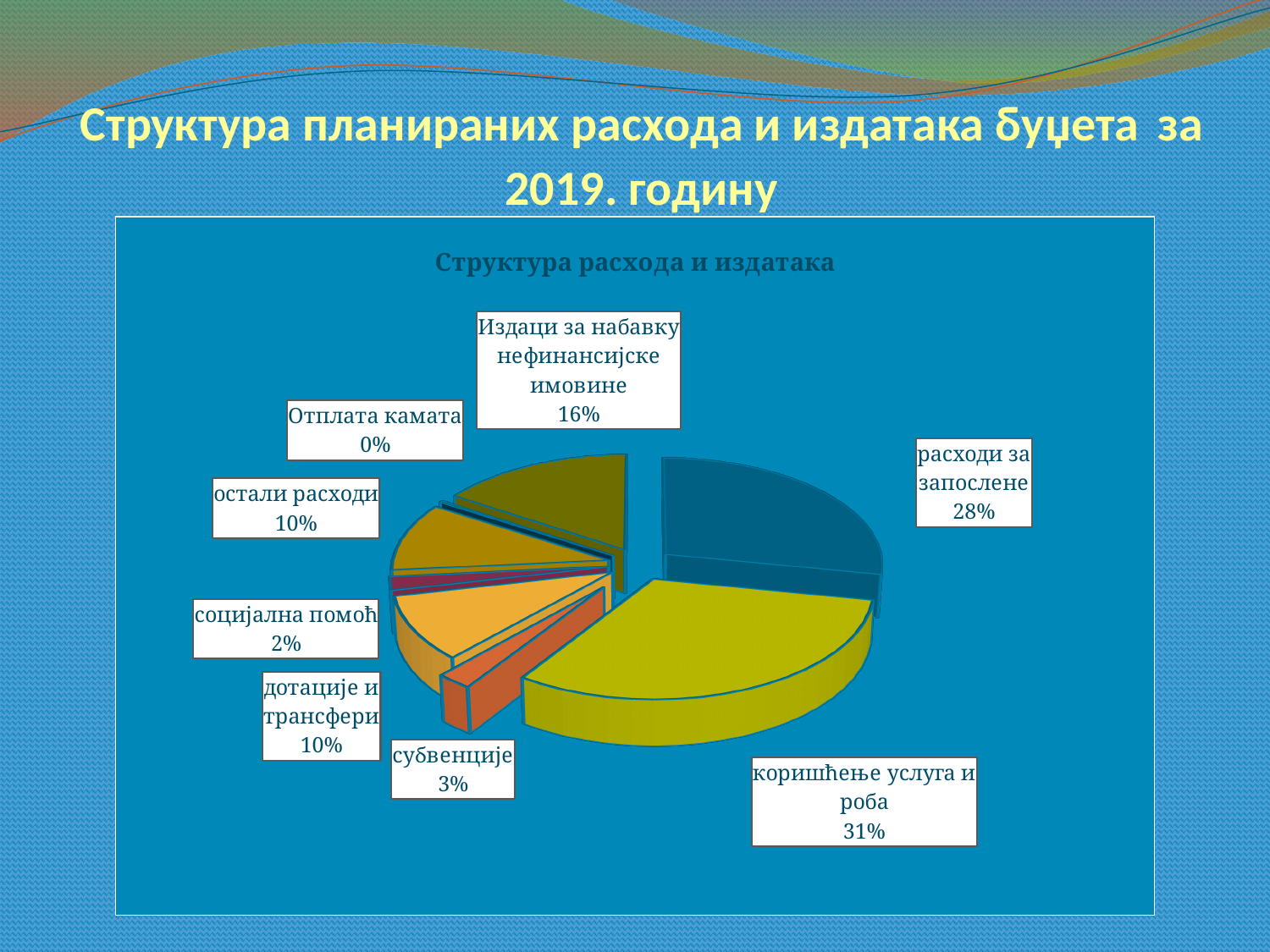
What is the difference in percentage points between коришћење услуга и роба and расходи за запослене? 3 What share of the pie is labelled for расходи за запослене? 28% Which category has the largest share of the pie? коришћење услуга и роба What is the title of the chart? Структура расхода и издатака How many categories (slices) are labelled on the pie chart? 8 What percentage is shown for социјална помоћ? 2% What percentage is shown for Издаци за набавку нефинансијске имовине? 16% What share of the pie is labelled for коришћење услуга и роба? 31% What percentage is shown for субвенције? 3% What kind of chart is shown on the slide? pie chart What percentage is shown for Отплата камата? 0% Which category has the smallest share of the pie? Отплата камата